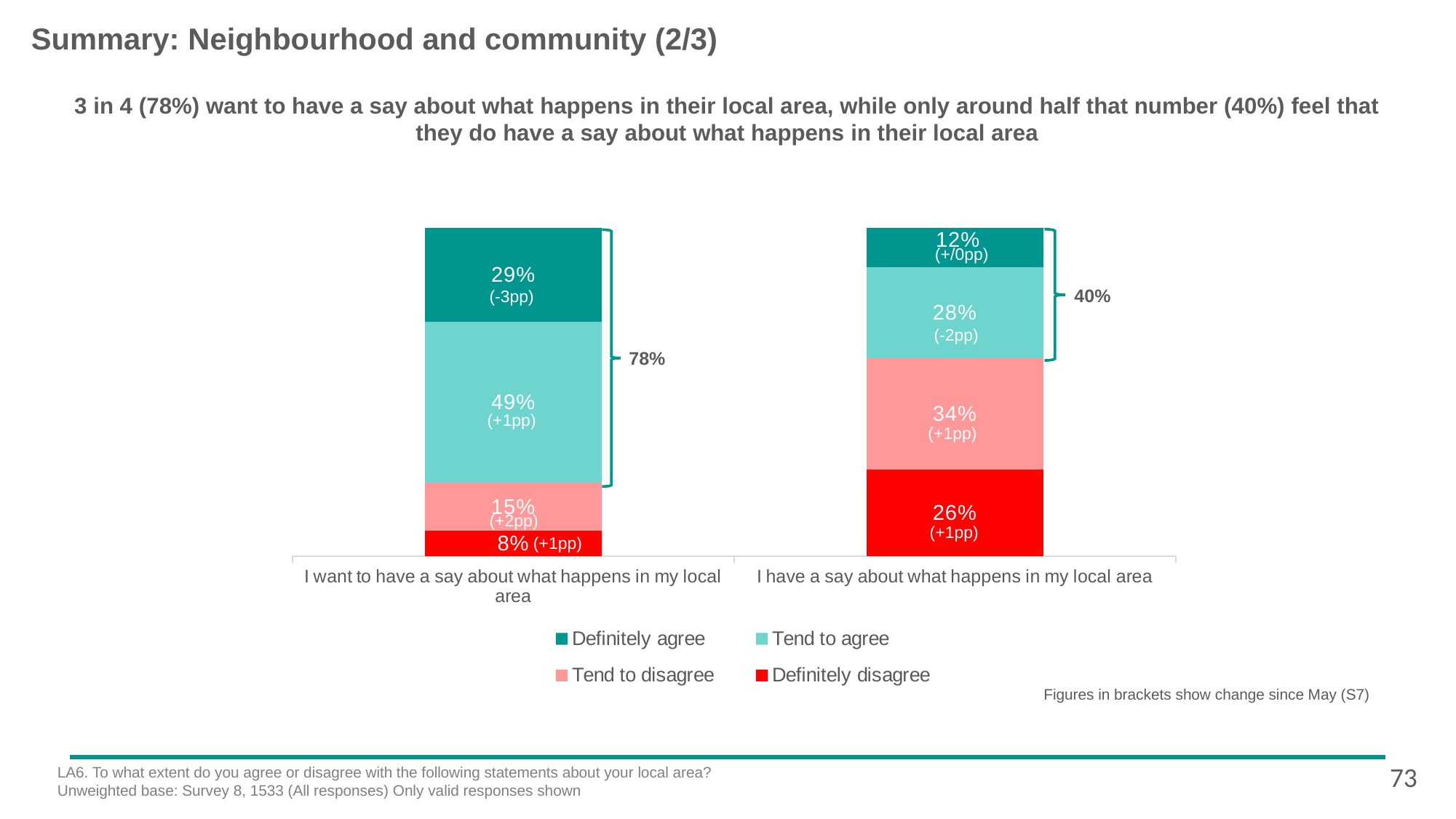
What was the change since May for 'Definitely agree' on 'I want to have a say about what happens in my local area'? -3pp Which response category is the largest for 'I want to have a say about what happens in my local area'? Tend to agree How many series does the legend list? 4 What percentage of respondents 'Tend to disagree' with 'I want to have a say about what happens in my local area'? 15% What is the combined agreement (Definitely agree plus Tend to agree) shown for 'I have a say about what happens in my local area'? 40% What percentage of respondents 'Definitely disagree' with 'I have a say about what happens in my local area'? 26% What is the difference between the 'Tend to agree' values for the two statements? 21 percentage points Which statement has the larger 'Definitely disagree' share? I have a say about what happens in my local area What percentage of respondents 'Definitely agree' with 'I want to have a say about what happens in my local area'? 29% What percentage of respondents 'Tend to agree' with 'I have a say about what happens in my local area'? 28% What kind of chart is shown on the slide? Stacked bar chart What is the combined agreement (Definitely agree plus Tend to agree) shown for 'I want to have a say about what happens in my local area'? 78%